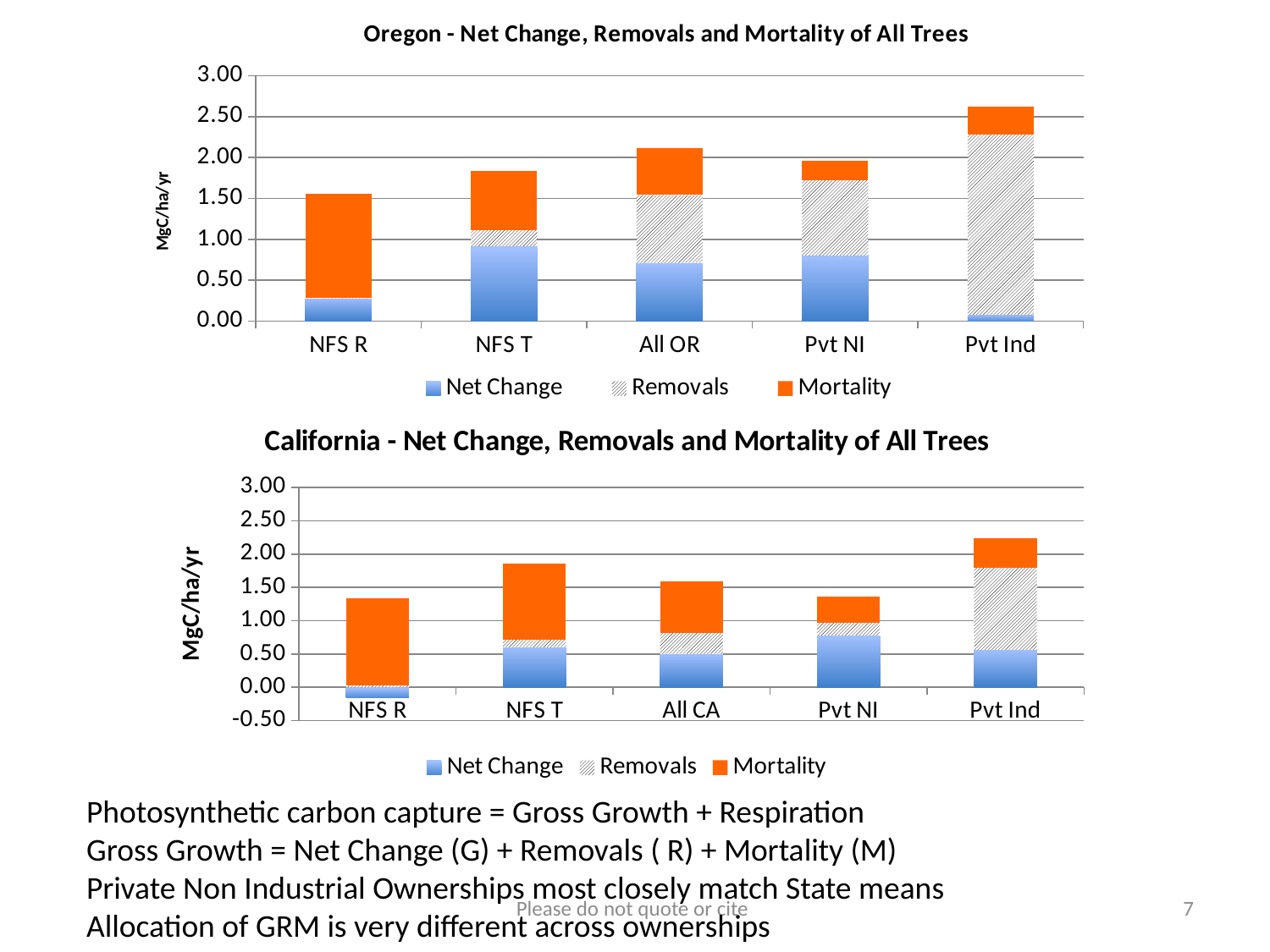
In the California chart, which category has the tallest stacked bar? Pvt Ind In the Oregon chart, is the total stacked value for NFS R greater or less than 2.00? less In the California chart, is the total stacked value for NFS R greater or less than 1.50? less How many series does the legend of the California - Net Change, Removals and Mortality of All Trees chart list? 3 In the Oregon chart, which category has the shortest stacked bar? NFS R In the Oregon chart, is the total stacked value for Pvt Ind greater or less than 2.50? greater What is the y-axis label on the California chart? MgC/ha/yr In the Oregon chart, which category has the tallest stacked bar? Pvt Ind In the California chart, which has the taller stacked bar, NFS T or All CA? NFS T What kind of chart is the Oregon - Net Change, Removals and Mortality of All Trees chart? Stacked bar chart How many ownership categories are shown on the x axis of the Oregon chart? 5